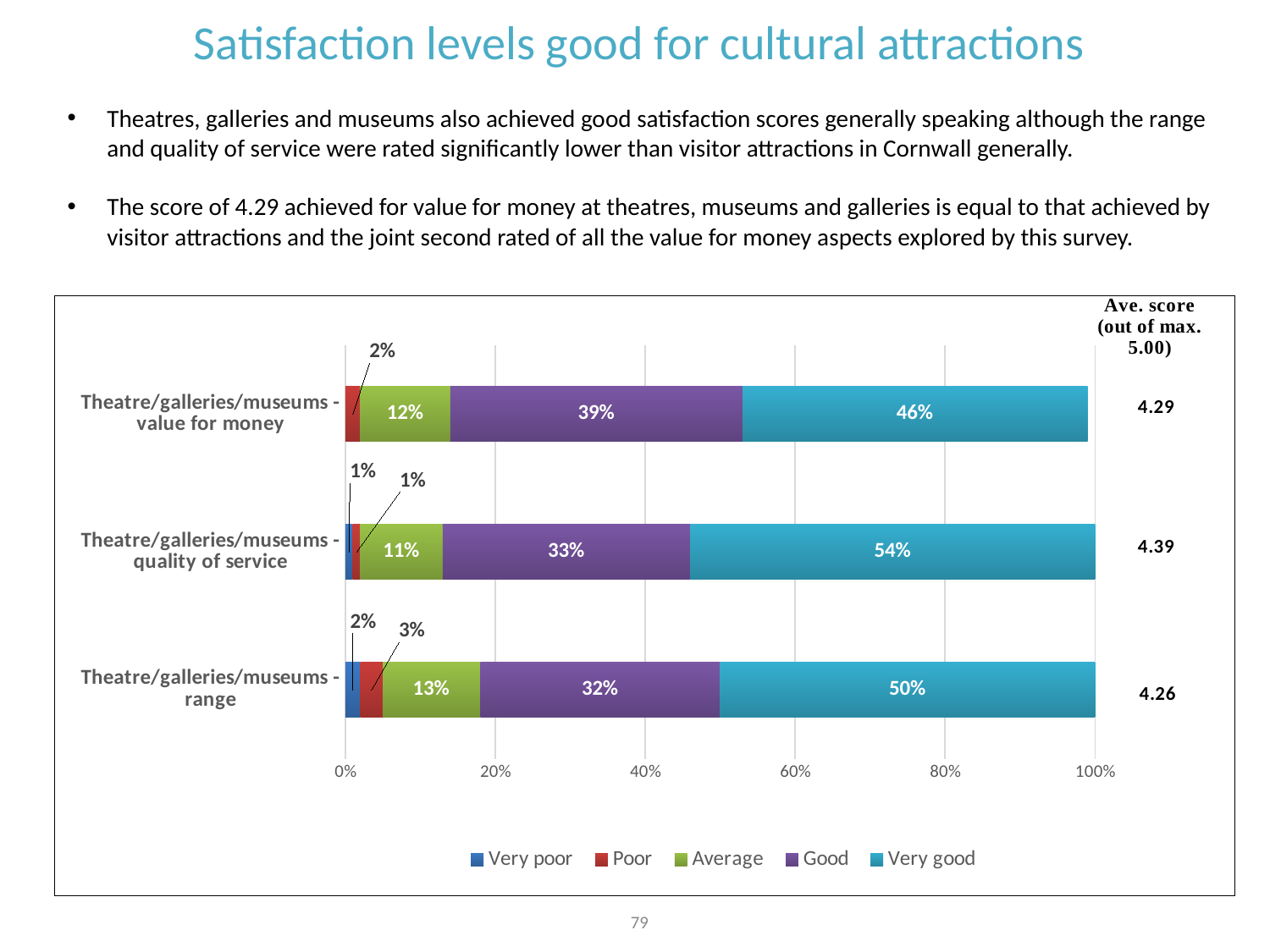
What is the average score (out of max. 5.00) shown for Theatre/galleries/museums - quality of service? 4.39 Which is larger: the 'Good' percentage for value for money or the 'Good' percentage for range? Value for money (39%) What is the 'Poor' percentage for Theatre/galleries/museums - value for money? 2% How many categories (bars) are shown on the chart? 3 How many series does the legend list? 5 What is the difference in percentage points between the 'Very good' share for quality of service and the 'Very good' share for range? 4 percentage points What percentage rated Theatre/galleries/museums - range as 'Average'? 13% What percentage rated Theatre/galleries/museums - quality of service as 'Good'? 33% What type of chart is shown on the slide? Stacked bar chart Which category has the lowest average score shown on the chart? Theatre/galleries/museums - range What percentage of respondents rated Theatre/galleries/museums - value for money as 'Very good'? 46% Which category has the highest 'Very good' percentage? Theatre/galleries/museums - quality of service